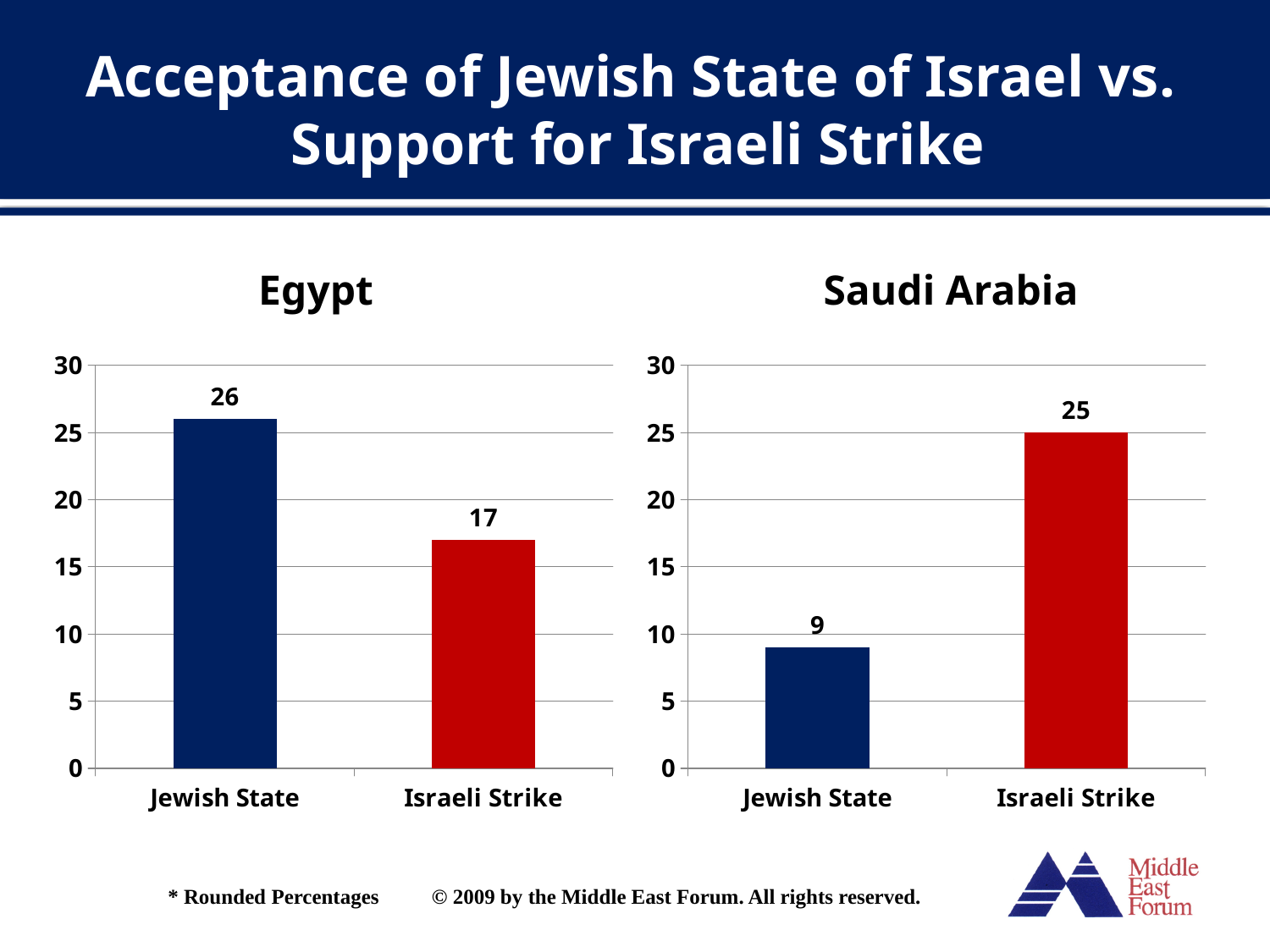
In the Egypt chart, what colour is the Israeli Strike bar? Red In the Saudi Arabia chart, which is larger: Jewish State or Israeli Strike? Israeli Strike In the Egypt chart, what is the difference between the Jewish State and Israeli Strike values? 9 In the Saudi Arabia chart, what is the value for Israeli Strike? 25 In the Egypt chart, which category has the highest value? Jewish State In the Egypt chart, what is the value for Jewish State? 26 In the Saudi Arabia chart, which category has the lowest value? Jewish State In the Saudi Arabia chart, what is the value for Jewish State? 9 What type of chart is the Saudi Arabia chart? Bar chart In the Egypt chart, how many categories are shown? 2 In the Saudi Arabia chart, what is the difference between the Israeli Strike and Jewish State values? 16 In the Egypt chart, what is the value for Israeli Strike? 17